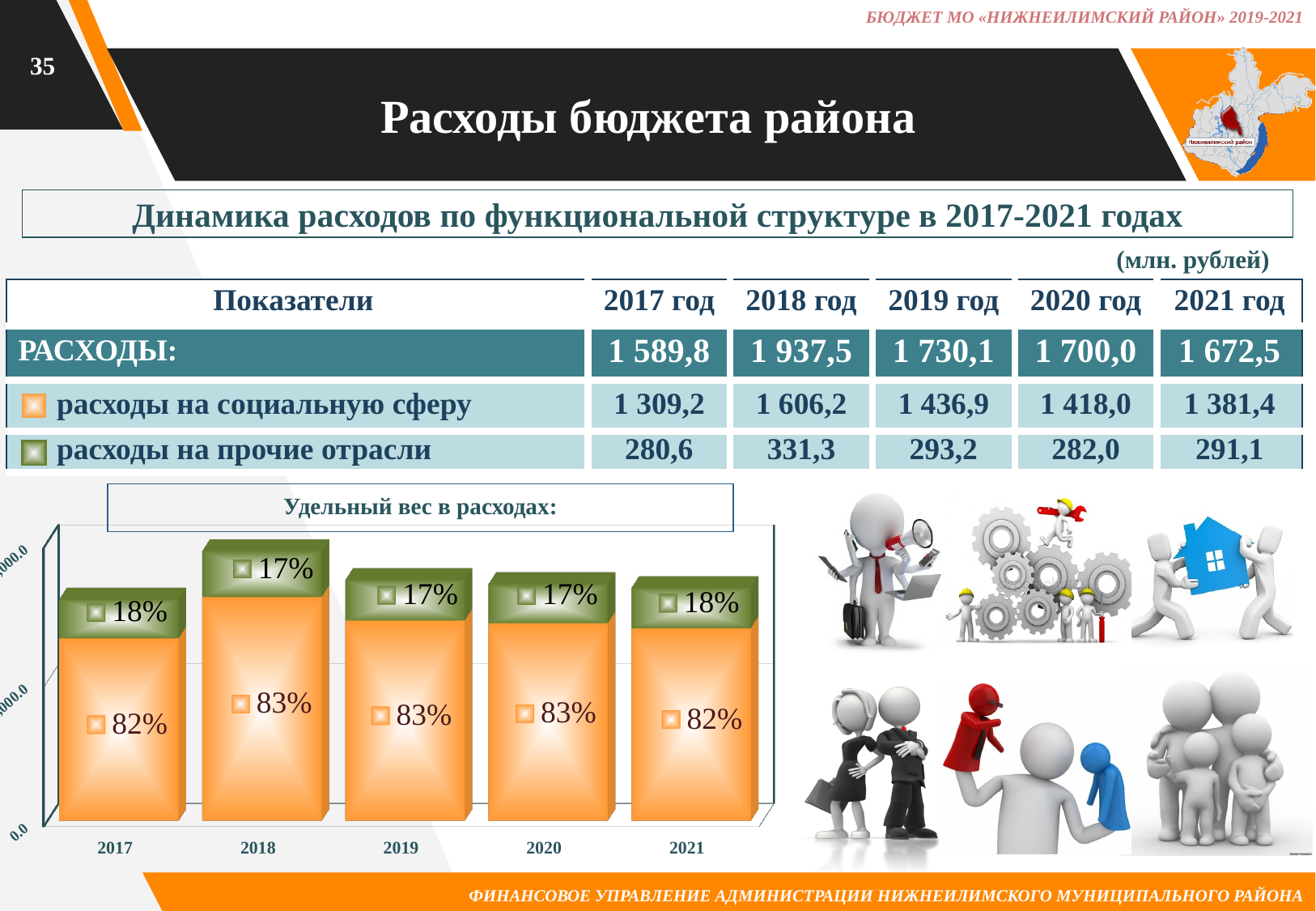
In the "Удельный вес в расходах:" chart, what is the total of the two segments for 2019? 100% What is the title of the bar chart on the slide? Удельный вес в расходах: In the "Удельный вес в расходах:" chart, what is the difference between the orange and green segments for 2017? 64% In the "Удельный вес в расходах:" chart, which segment is larger for 2018, the orange one or the green one? the orange one In the "Удельный вес в расходах:" chart, what is the value of the green segment for 2018? 17% In the "Удельный вес в расходах:" chart, what is the value of the green segment for 2021? 18% In the "Удельный вес в расходах:" chart, what is the value of the orange segment for 2017? 82% How many years (categories) are shown on the x axis of the "Удельный вес в расходах:" chart? 5 What kind of chart is shown under the heading "Удельный вес в расходах:"? stacked bar chart In the "Удельный вес в расходах:" chart, in which years does the green segment equal 18%? 2017 and 2021 In the "Удельный вес в расходах:" chart, what is the value of the orange segment for 2020? 83% In the "Удельный вес в расходах:" chart, how does the orange segment change from 2017 to 2018? rises from 82% to 83%